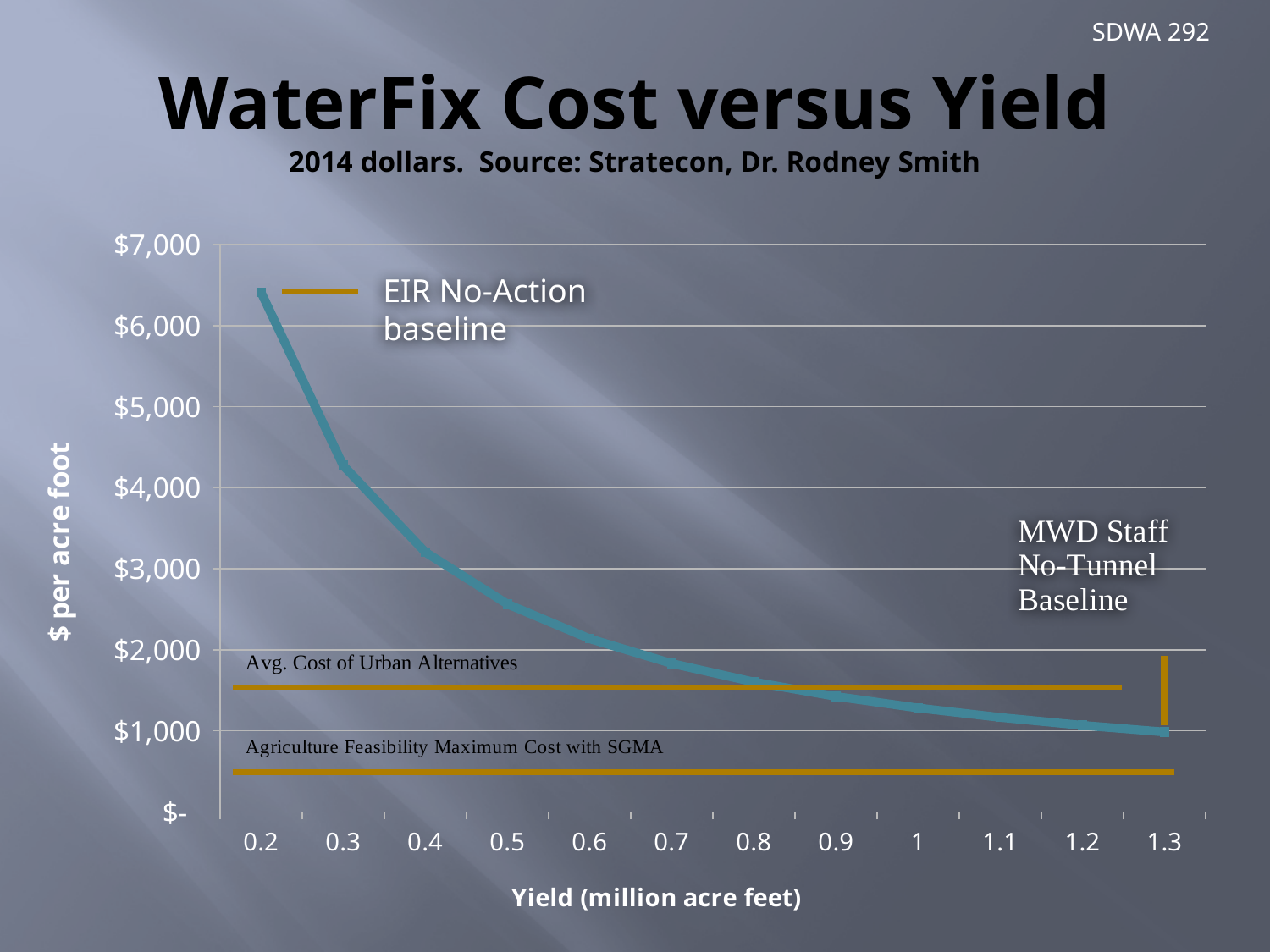
Is the cost per acre foot at a yield of 1.3 million acre feet greater or less than $2,000? less Which of the two horizontal reference lines is lower: Avg. Cost of Urban Alternatives or Agriculture Feasibility Maximum Cost with SGMA? Agriculture Feasibility Maximum Cost with SGMA Is the cost per acre foot at a yield of 0.3 million acre feet greater or less than $3,000? greater Is the cost per acre foot at a yield of 0.2 million acre feet greater or less than $6,000? greater How many yield values are labelled on the x axis? 12 What is the label on the vertical axis? $ per acre foot What is the highest value labelled on the vertical axis? $7,000 What kind of chart is shown on the slide? Line chart Does the cost per acre foot rise or fall as yield increases along the x axis? Fall What is the title of the chart? WaterFix Cost versus Yield